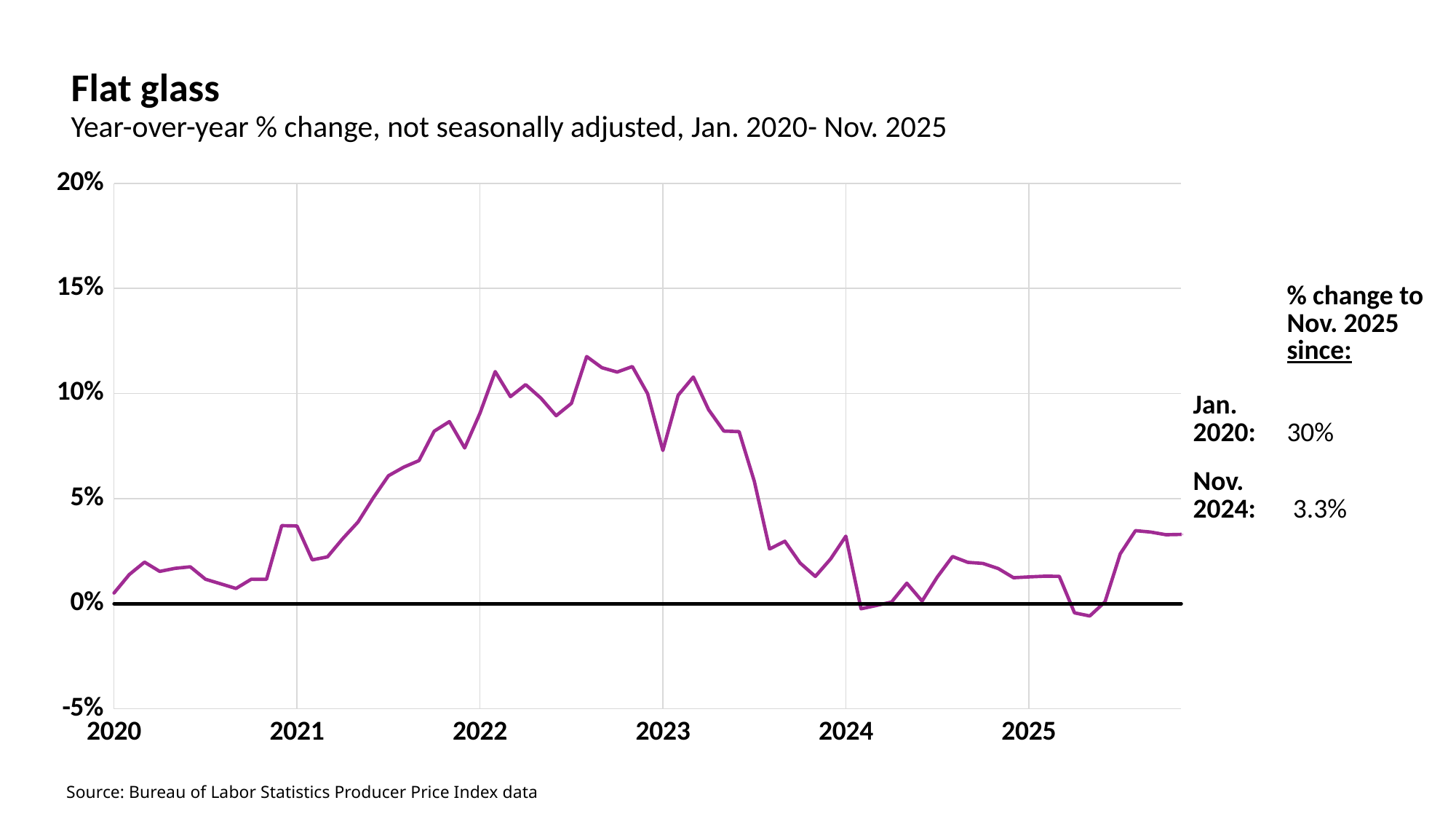
Is the highest point of the line greater or less than 10%? greater What is the title of the chart? Flat glass What is the source cited for the chart data? Bureau of Labor Statistics Producer Price Index data According to the annotation, what is the % change to Nov. 2025 since Jan. 2020? 30% According to the annotation, what is the % change to Nov. 2025 since Nov. 2024? 3.3% Is the year-over-year % change at the start of 2024 greater or less than 5%? less Is the year-over-year % change at the start of 2022 greater or less than 5%? greater In which year does the line reach its highest value? 2022 What kind of chart is shown on the slide? line chart Does the year-over-year % change rise or fall between the start of 2023 and the start of 2024? fall